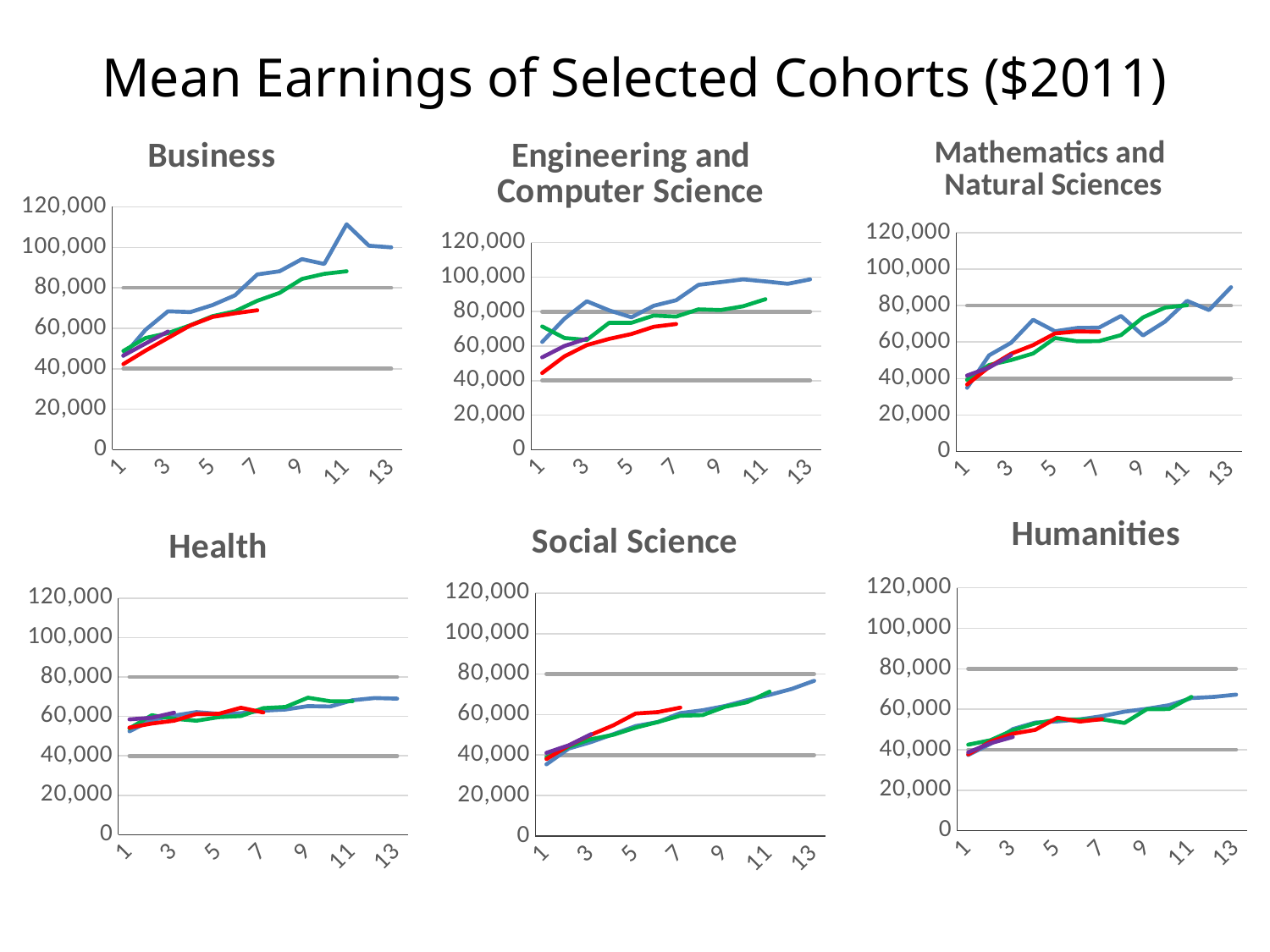
What is the title of the slide? Mean Earnings of Selected Cohorts ($2011) At which two values are the gray horizontal reference lines drawn in each chart? 80,000 and 40,000 How many charts are shown on the slide? 6 In the Humanities chart, is the value of the green line at point 1 greater or less than 60,000? less In the Social Science chart, do the values of the blue line rise or fall along the x axis? rise In the Mathematics and Natural Sciences chart, is the value of the blue line at point 13 greater or less than 80,000? greater In the Health chart, is the value of the blue line at point 13 greater or less than 80,000? less In the Business chart, at point 11, which line is higher, the blue line or the green line? blue line In the Health chart, do the values of the blue line rise or fall along the x axis? rise What kind of chart is the Business chart? line chart